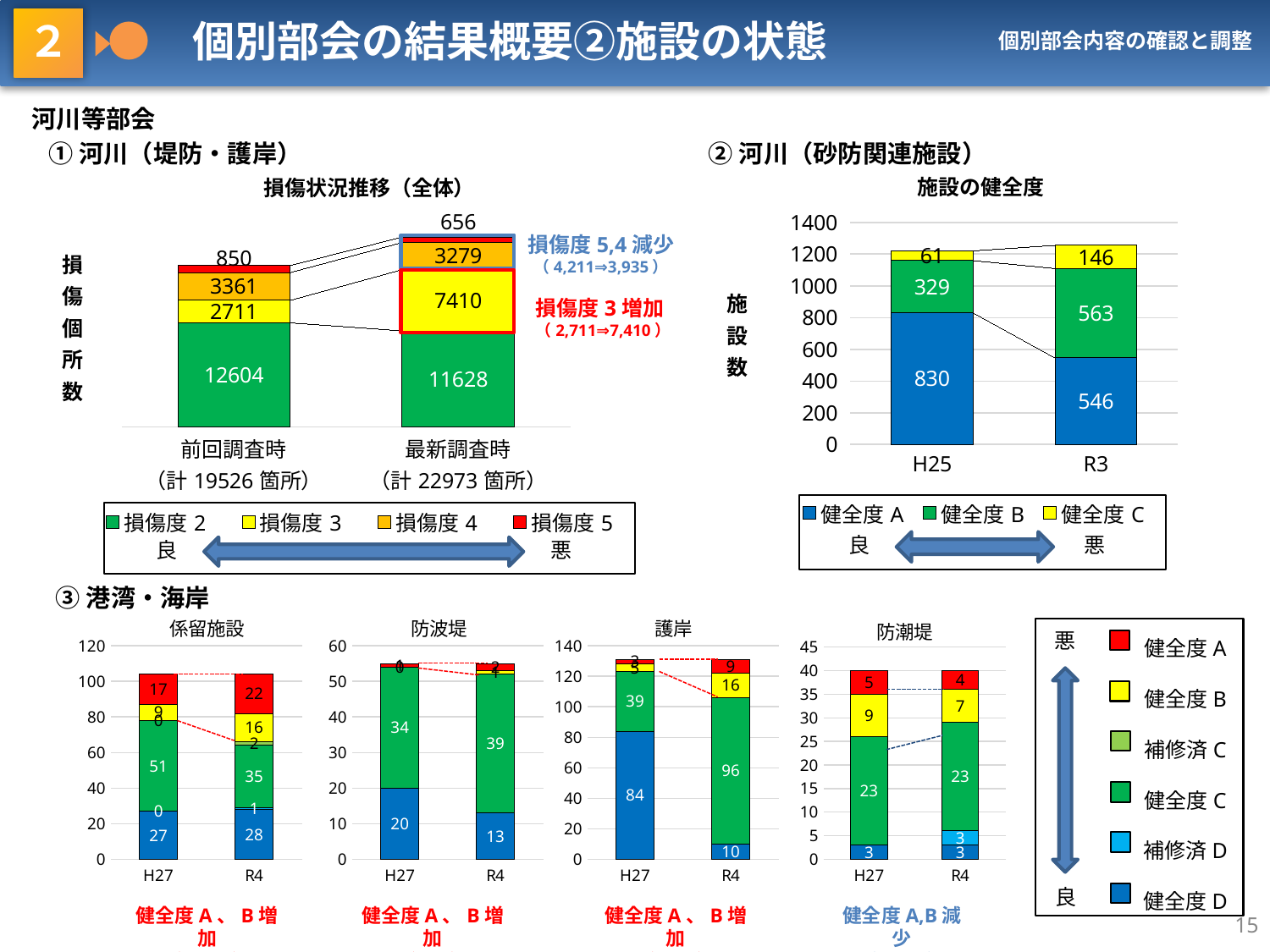
In the 施設の健全度 chart, what is the value for 健全度 A at H25? 830 In the 施設の健全度 chart, what is the value for 健全度 C at R3? 146 In the 施設の健全度 chart, which is larger at R3, 健全度 A or 健全度 B? 健全度 B In the 護岸 chart under ③ 港湾・海岸, what is the value for 健全度 C at R4? 96 In the 損傷状況推移（全体） chart, what is the total of the stacked bar for 前回調査時? 19526 In the 施設の健全度 chart, what is the total of the stacked bar for R3? 1255 In the 損傷状況推移（全体） chart, how many series does the legend list? 4 In the 損傷状況推移（全体） chart, what is the difference between the 損傷度 3 values at 最新調査時 and 前回調査時? 4699 In the 損傷状況推移（全体） chart, what is the value for 損傷度 2 at 最新調査時? 11628 In the 損傷状況推移（全体） chart, what is the value for 損傷度 3 at 前回調査時? 2711 In the 防潮堤 chart under ③ 港湾・海岸, what is the value for 健全度 B at H27? 9 What kind of chart is the 施設の健全度 chart? Stacked bar chart